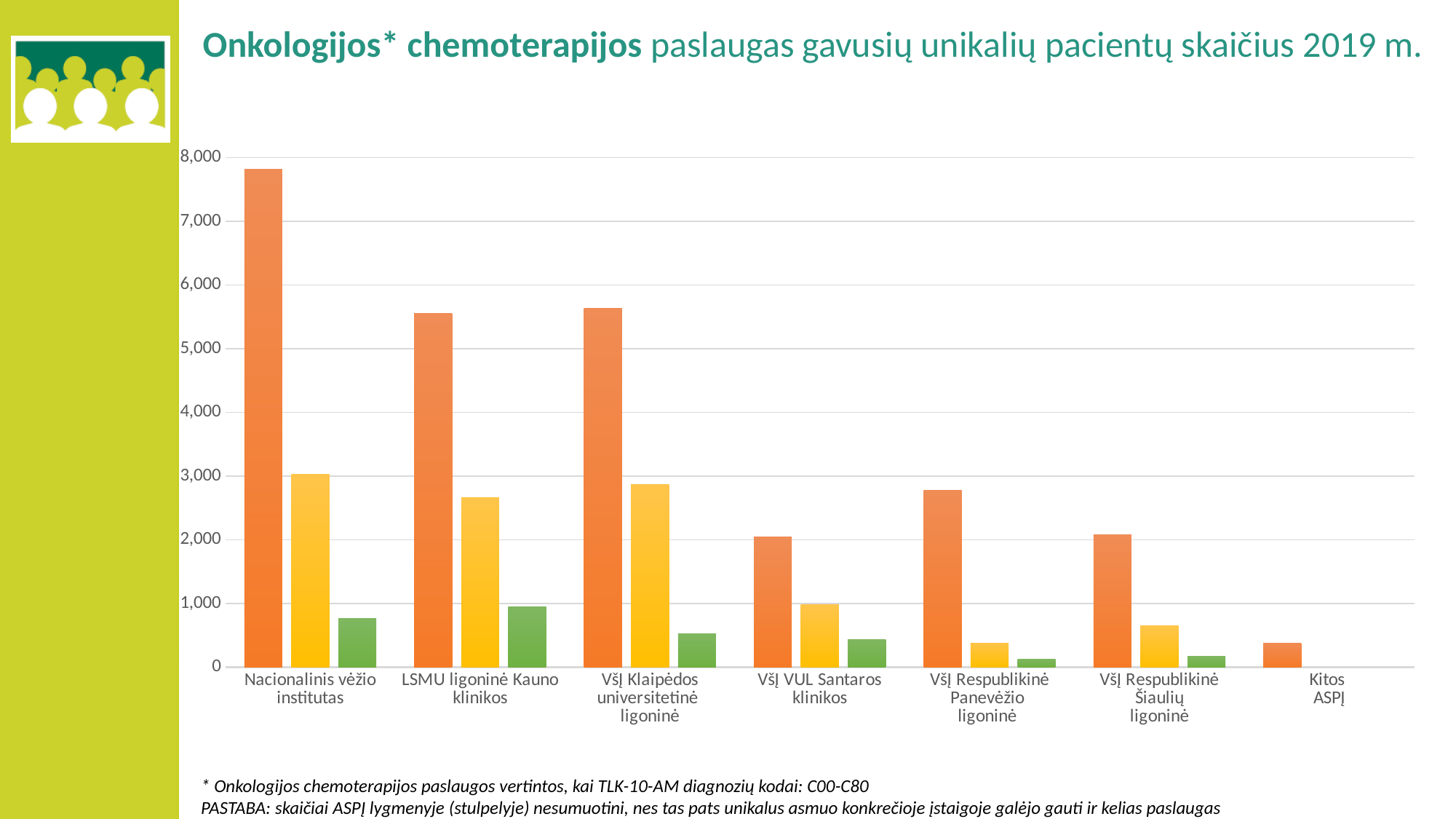
Is the orange bar for VšĮ VUL Santaros klinikos greater or less than 3,000? less Which has the larger green bar: LSMU ligoninė Kauno klinikos or VšĮ Klaipėdos universitetinė ligoninė? LSMU ligoninė Kauno klinikos What kind of chart is shown on the slide? bar chart Is the green bar for LSMU ligoninė Kauno klinikos greater or less than 500? greater Is the orange bar for VšĮ Respublikinė Panevėžio ligoninė greater or less than 2,000? greater Which has the larger orange bar: VšĮ Respublikinė Panevėžio ligoninė or VšĮ Respublikinė Šiaulių ligoninė? VšĮ Respublikinė Panevėžio ligoninė How many categories (institutions) are shown on the x axis? 7 Which institution has the tallest orange bar? Nacionalinis vėžio institutas What year does the chart title say the data is for? 2019 m. Which institution has the lowest orange bar? Kitos ASPĮ